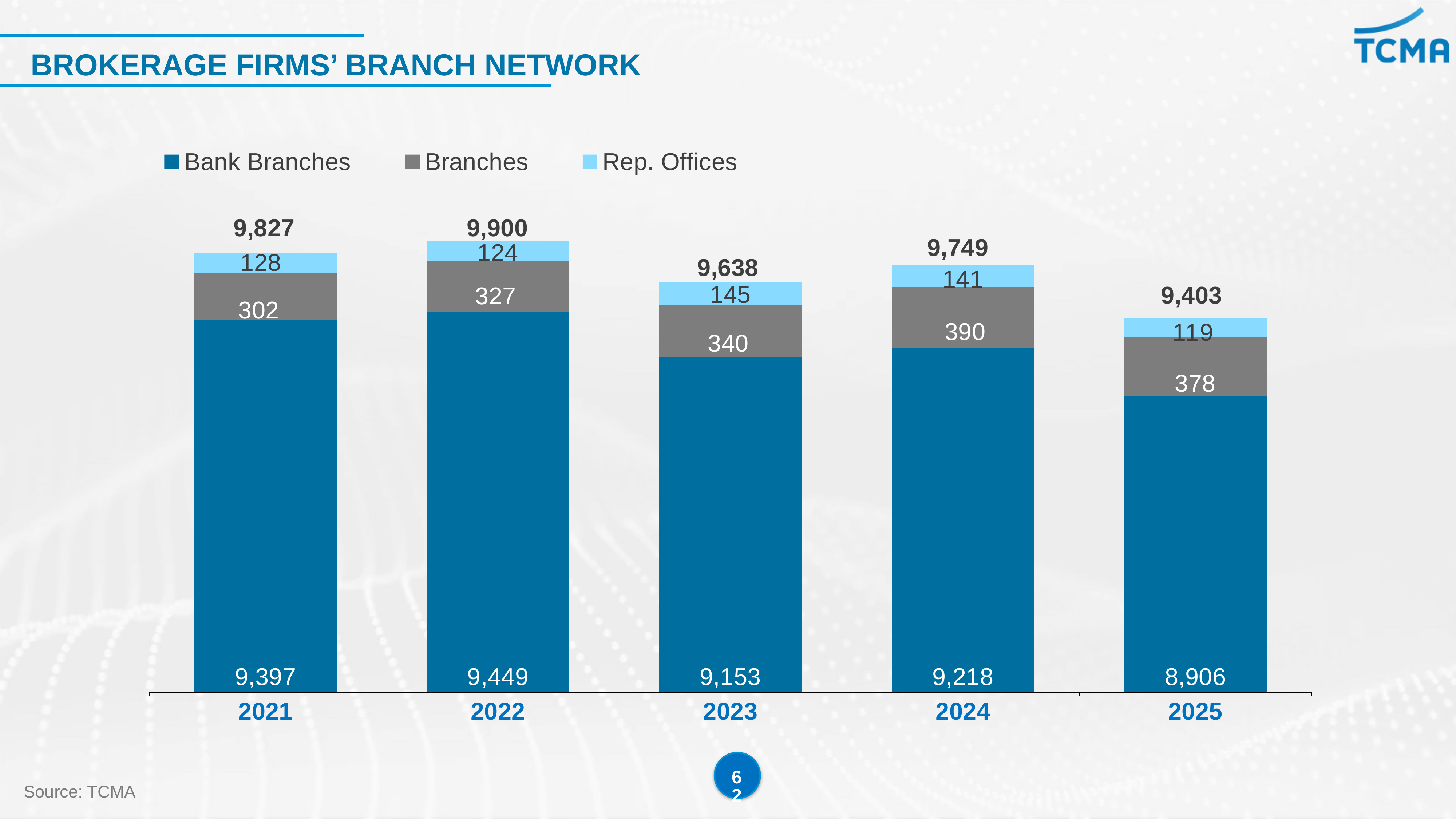
Which is larger, the Branches value in 2024 or in 2023? 2024 Which year has the highest total branch network? 2022 What is the difference between the Bank Branches values for 2022 and 2025? 543 What is the total of the stacked bar for 2021? 9,827 Which series is shown in light blue in the legend? Rep. Offices Which year has the lowest value for Bank Branches? 2025 How many years are shown on the x axis? 5 How many series does the legend list? 3 What is the value for Bank Branches in 2023? 9,153 What is the value for Rep. Offices in 2024? 141 What is the value for Branches in 2025? 378 What kind of chart is shown on the slide? Stacked bar chart